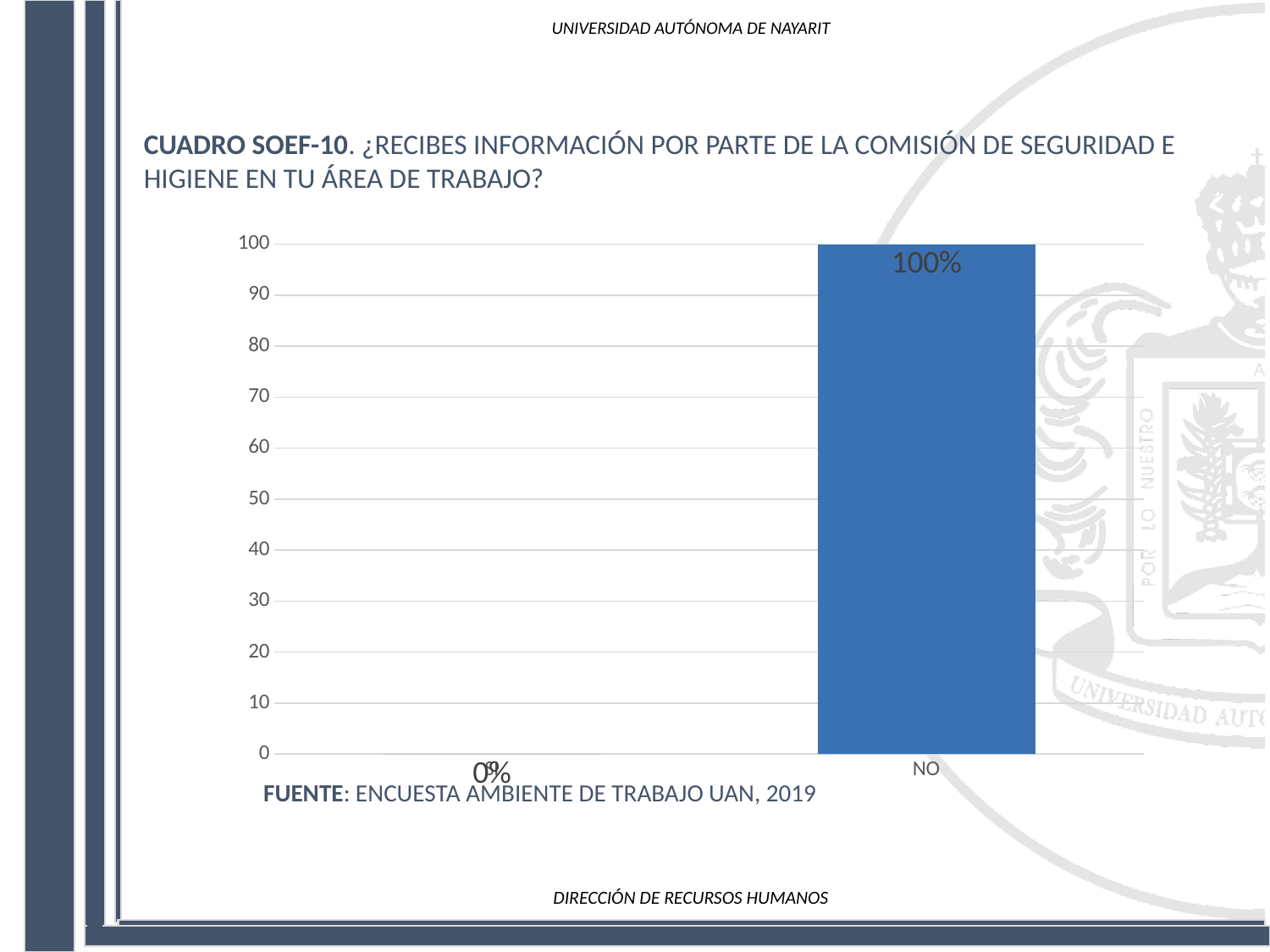
What is the value for NO? 100% What is the value shown for the left-hand category? 0% Which is larger, the value for NO or the value for the left-hand category? NO What type of chart is shown on the slide? bar chart What is the source cited below the chart? ENCUESTA AMBIENTE DE TRABAJO UAN, 2019 How many categories are shown on the x axis? 2 Is the value for NO greater or less than 50? greater Which category has the highest value? NO What is the maximum value shown on the vertical axis? 100 What is the difference between the value for NO and the value for the left-hand category? 100%